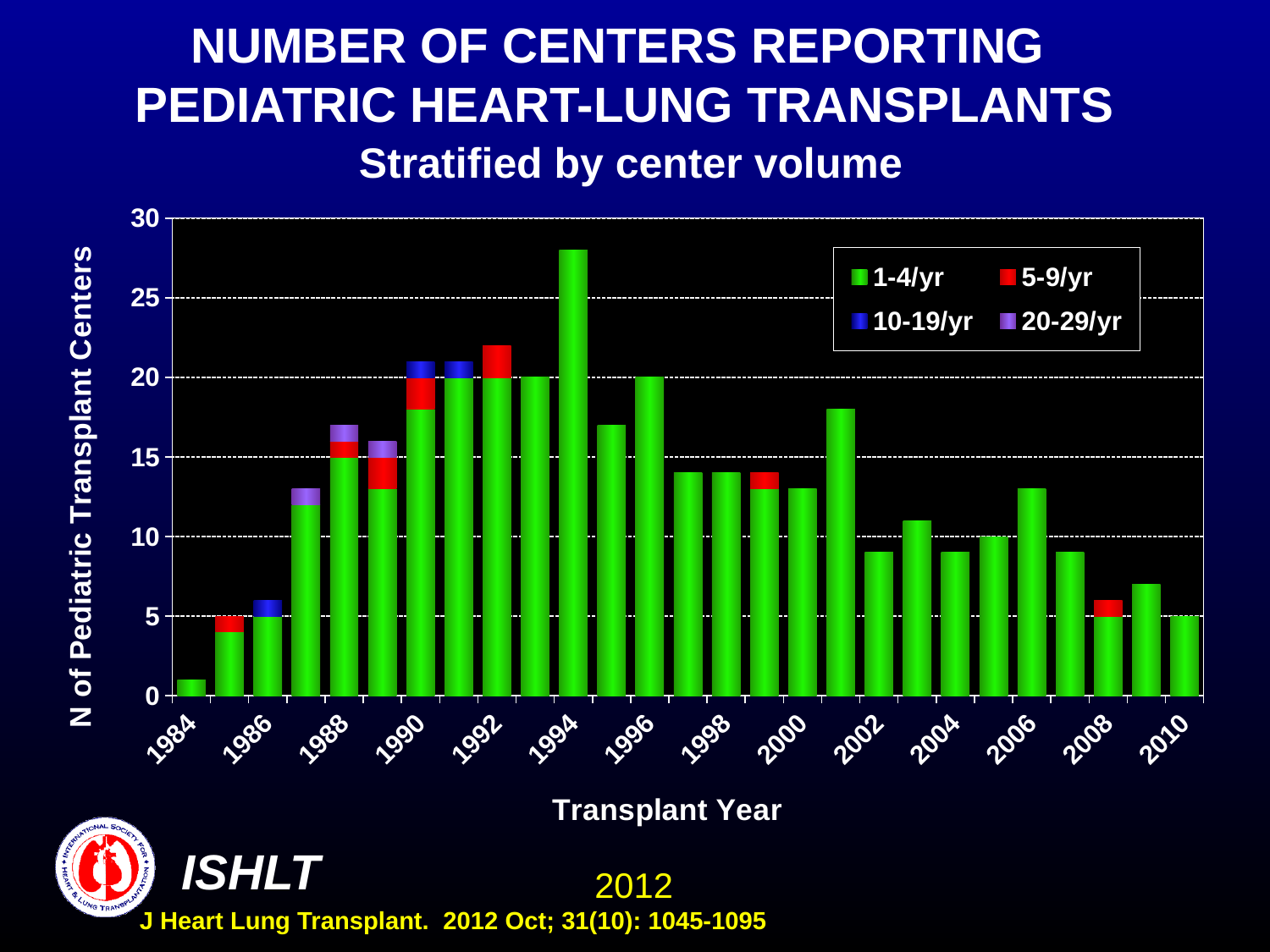
How many transplant years (bars) are plotted on the chart? 27 Is the total number of centers for 2002 greater or less than 10? less Which transplant year has the highest number of pediatric transplant centers? 1994 What is the total number of pediatric transplant centers reported for 1993? 20 Is the total number of centers for 1994 greater or less than 25? greater What kind of chart is shown on the slide? Stacked bar chart What is the label of the y axis? N of Pediatric Transplant Centers Which transplant year has the lowest number of pediatric transplant centers? 1984 Is the total number of centers for 1988 greater or less than 15? greater How many series does the legend list? 4 Which year has more reporting centers, 1996 or 2006? 1996 Do the number of centers generally rise or fall from 2001 to 2010? fall